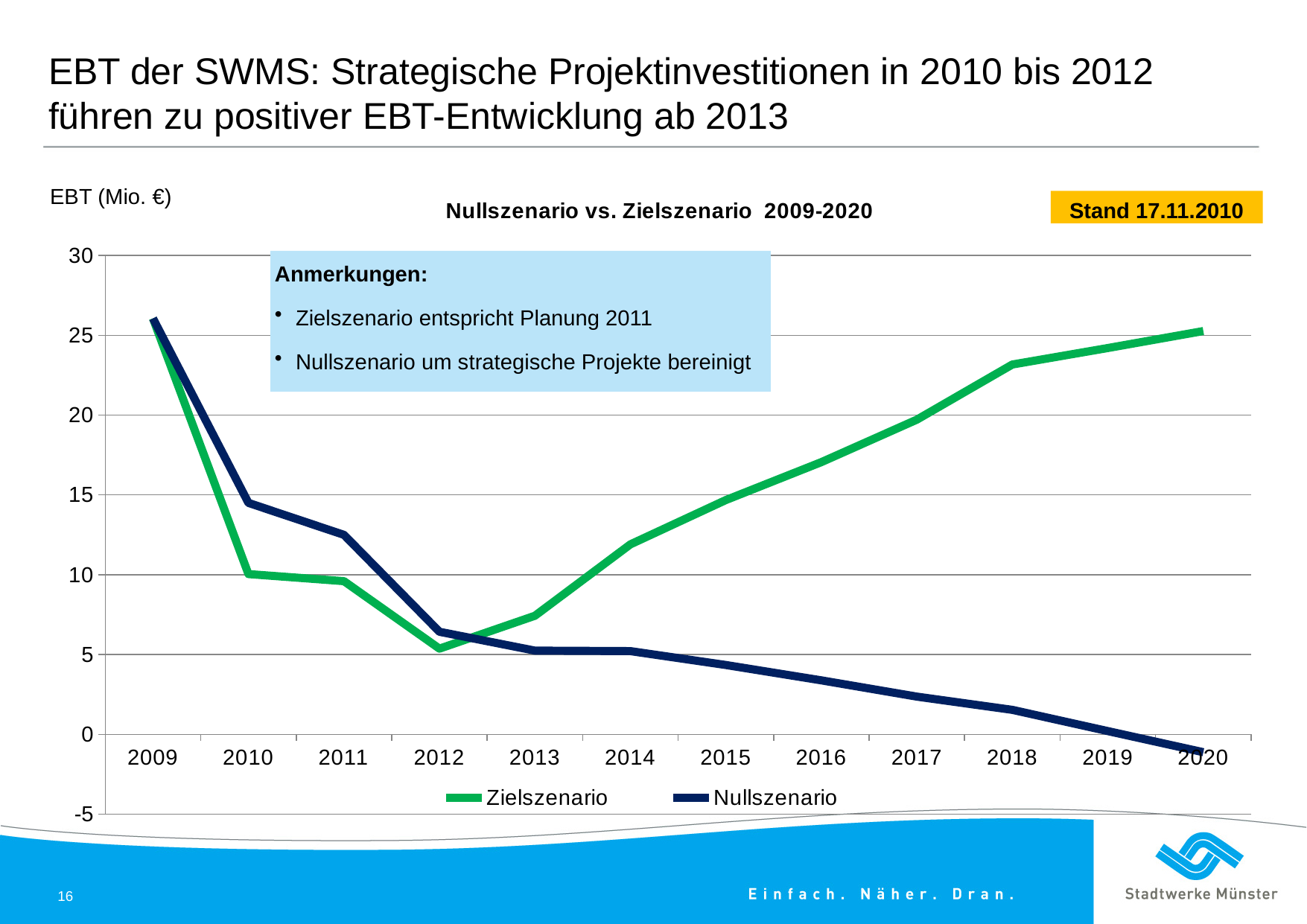
How many series does the chart legend list? 2 What is the title of the chart? Nullszenario vs. Zielszenario 2009-2020 In which year does the Zielszenario line reach its lowest value? 2012 How many years are plotted along the x axis? 12 Does the Nullszenario line rise or fall from 2009 to 2020? fall In which year does the Nullszenario line reach its lowest value? 2020 What kind of chart is shown on the slide? line chart Is the value for Nullszenario in 2020 greater or less than 0? less Is the value for Zielszenario in 2018 greater or less than 20? greater Which series has the larger value in 2017, Zielszenario or Nullszenario? Zielszenario Is the value for Nullszenario in 2016 greater or less than 5? less In which year does the Nullszenario line reach its highest value? 2009